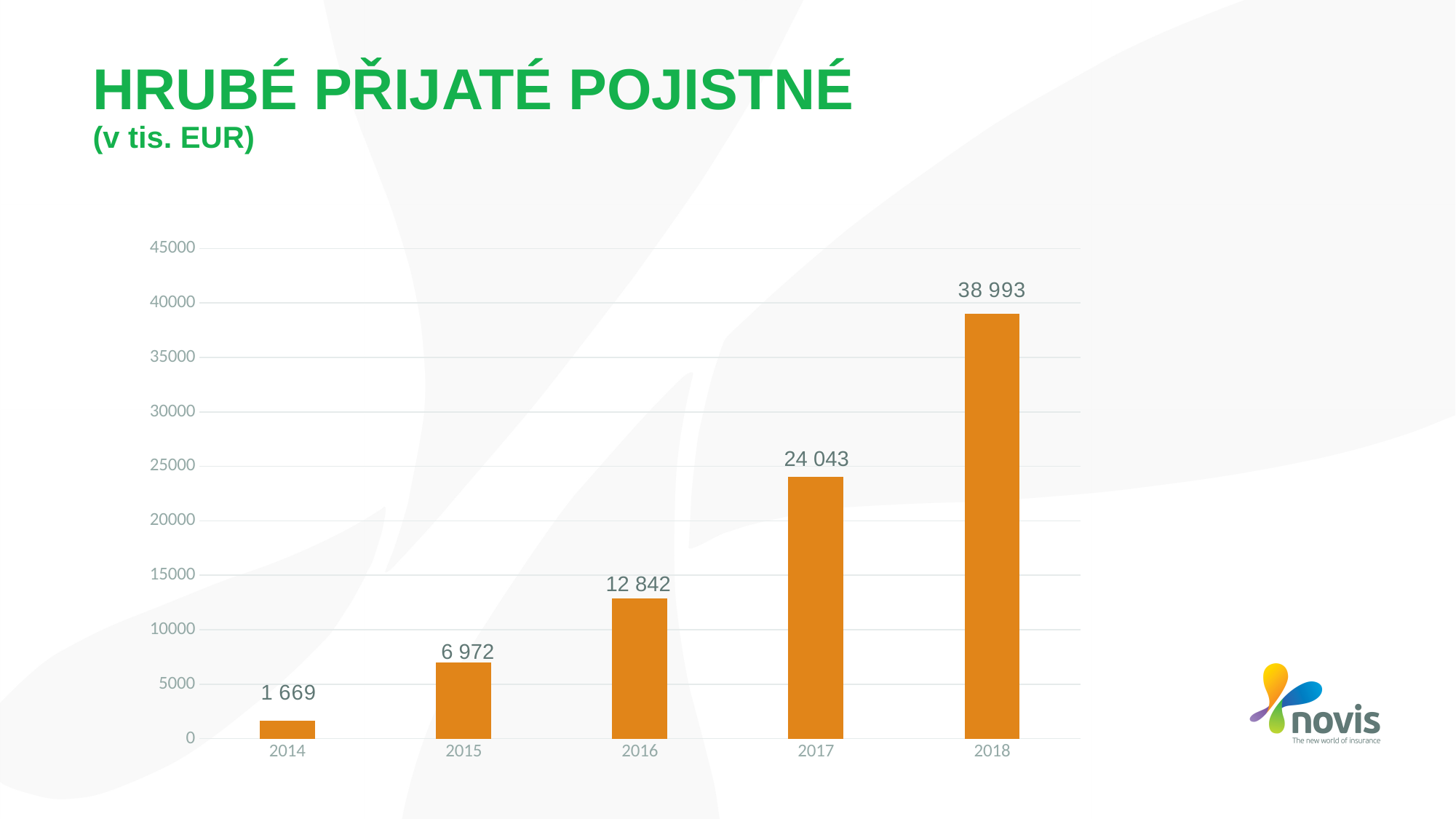
What is the value for 2016? 12 842 What is the value for 2018? 38 993 Do the values rise or fall from 2014 to 2018? rise Is the value for 2017 greater or less than 20000? greater What is the difference between the values for 2016 and 2015? 5 870 What is the difference between the values for 2018 and 2017? 14 950 How many years are shown on the x axis? 5 What kind of chart is shown on the slide? bar chart What is the value for 2014? 1 669 Which year has the highest value? 2018 Which is larger, the value for 2017 or the value for 2016? 2017 Which year has the lowest value? 2014